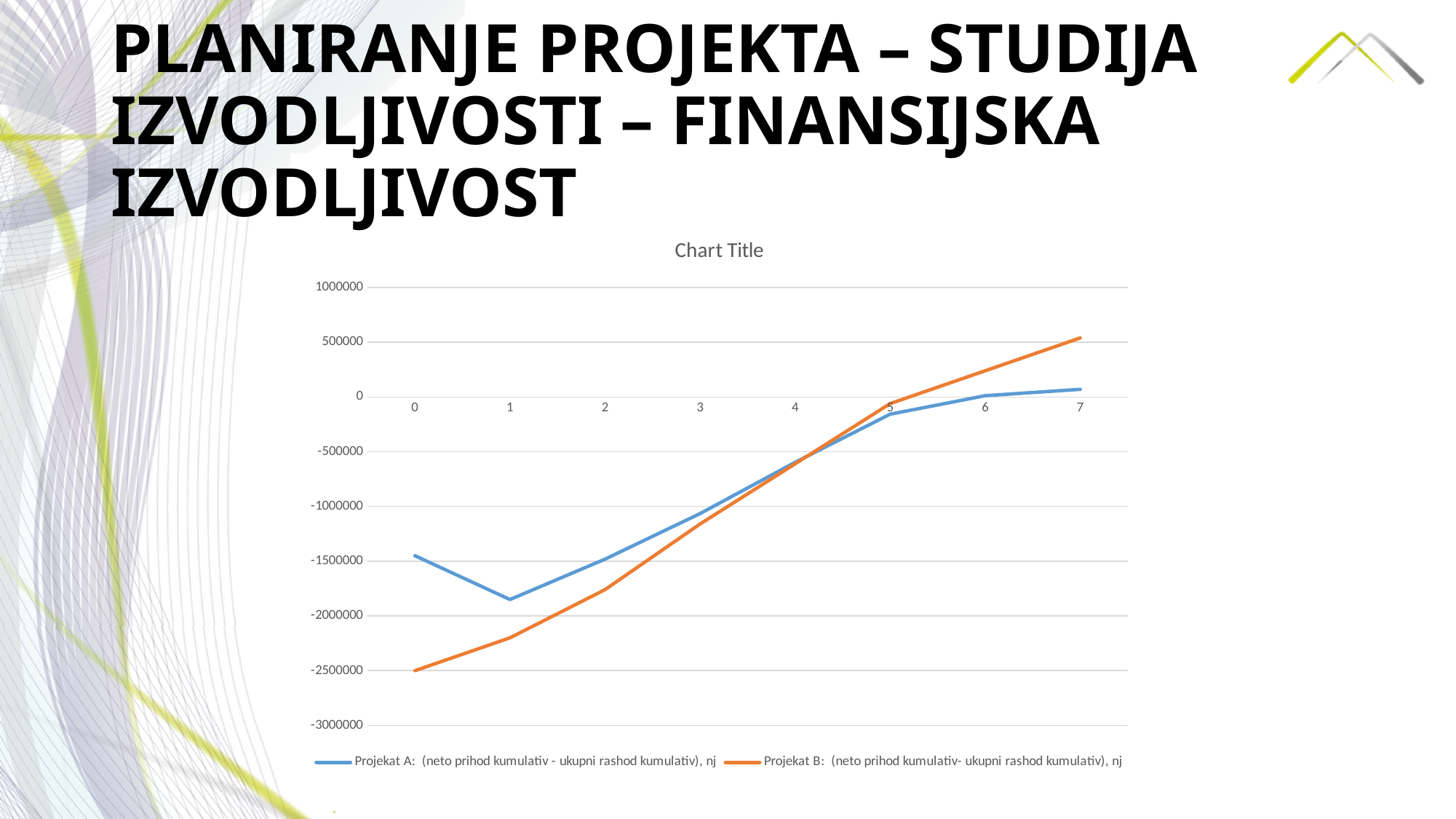
Is the value for Projekat A at x = 1 greater or less than -1500000? less What kind of chart is shown on the slide? line chart Does the Projekat B line rise or fall from x = 0 to x = 7? rise Is the value for Projekat B at x = 4 greater or less than -500000? less What is the value of Projekat B at x = 0? -2500000 How many points along the x axis does each line have? 8 Is the value for Projekat A at x = 3 greater or less than -1500000? greater What is the title shown above the chart? Chart Title At x = 0, which series has the higher value, Projekat A or Projekat B? Projekat A At x = 7, which series has the higher value, Projekat A or Projekat B? Projekat B How many series does the legend list? 2